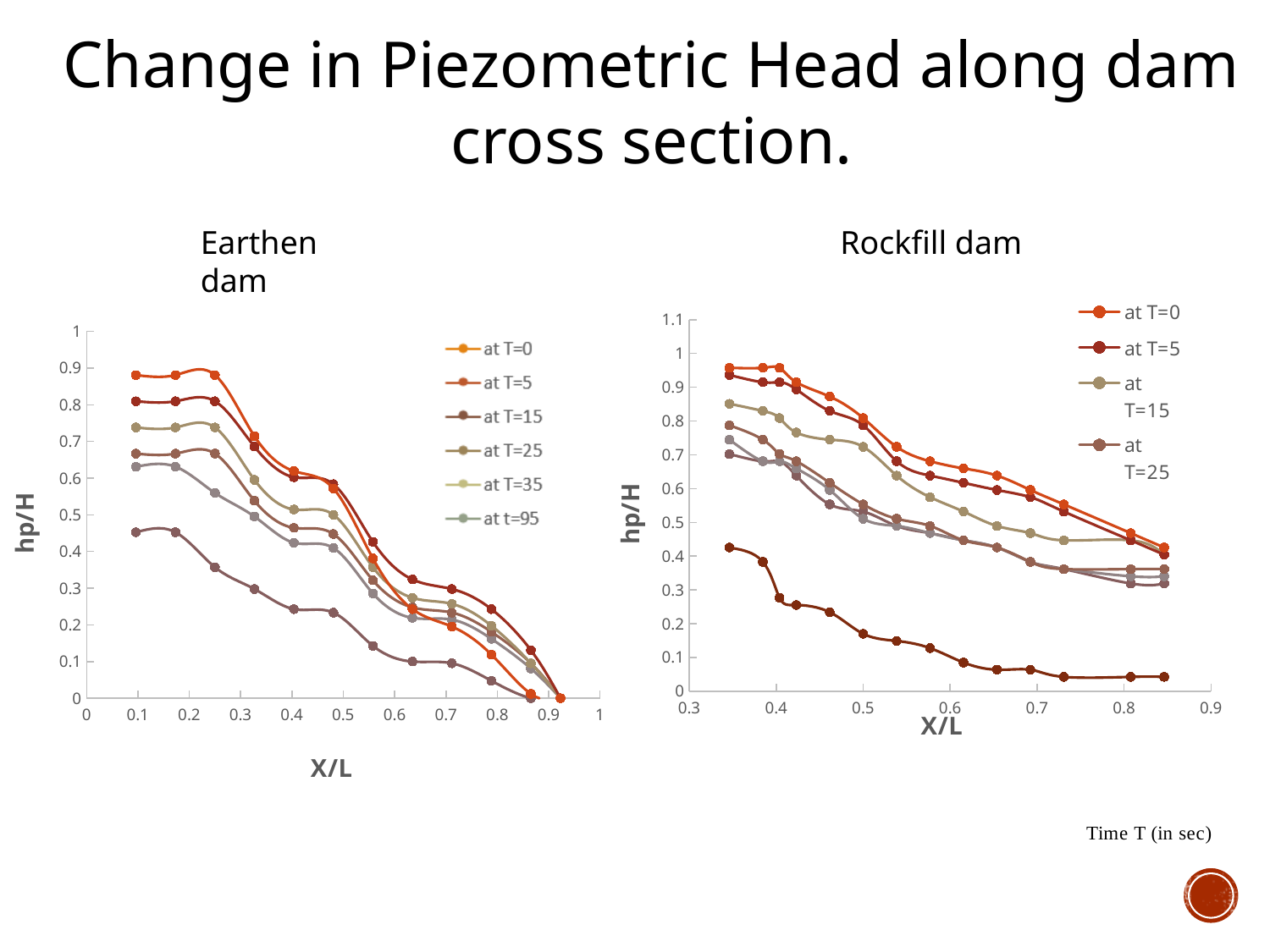
What is the label on the horizontal axis of the Rockfill dam chart? X/L In the Rockfill dam chart, is the value of the 'at T=0' series at its last point (X/L about 0.85) greater or less than 0.5? less In the Earthen dam chart, is the value of the 'at T=0' series at X/L = 0.1 greater or less than 0.8? greater In the Earthen dam chart, which series has the highest hp/H value at X/L = 0.1? at T=0 How many series does the legend of the Earthen dam chart list? 6 In the Rockfill dam chart, do the hp/H values rise or fall as X/L increases? fall In the Rockfill dam chart, is the value of the 'at T=0' series at its first point (X/L about 0.35) greater or less than 0.9? greater What kind of chart is the Rockfill dam chart? line chart What is the label on the vertical axis of the Earthen dam chart? hp/H What kind of chart is the Earthen dam chart? line chart In the Earthen dam chart, do the hp/H values rise or fall as X/L increases? fall